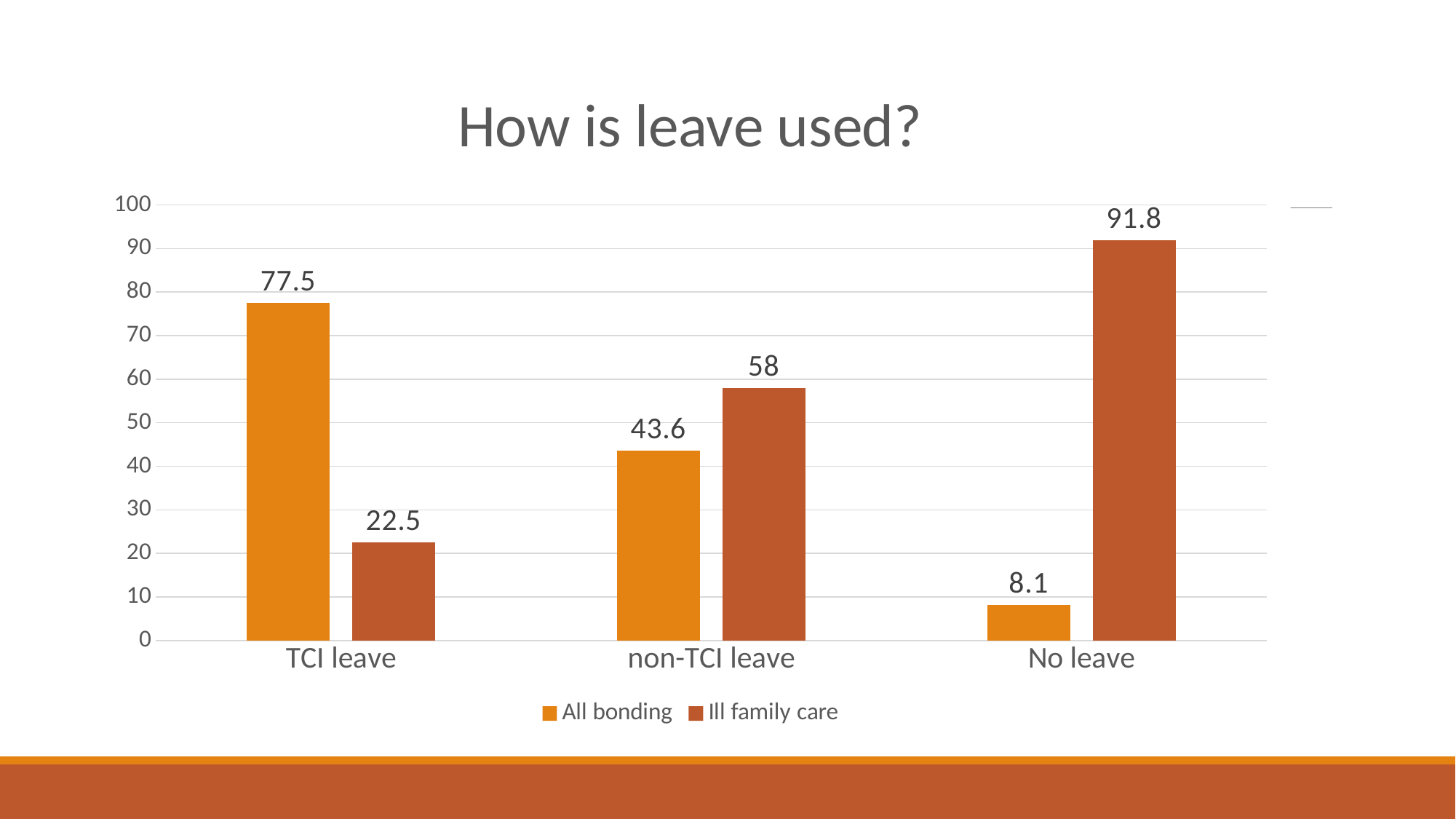
What is the value for All bonding in the No leave category? 8.1 What kind of chart is shown on the slide? Bar chart What is the value for All bonding in the TCI leave category? 77.5 What is the value for Ill family care in the No leave category? 91.8 How many series does the legend list? 2 What is the value for Ill family care in the non-TCI leave category? 58 What is the difference between the Ill family care and All bonding values for No leave? 83.7 How many categories are shown on the x axis? 3 What is the difference between the All bonding and Ill family care values for TCI leave? 55 Which category has the highest All bonding value? TCI leave In the non-TCI leave category, which series has the larger value, All bonding or Ill family care? Ill family care Which category has the lowest Ill family care value? TCI leave